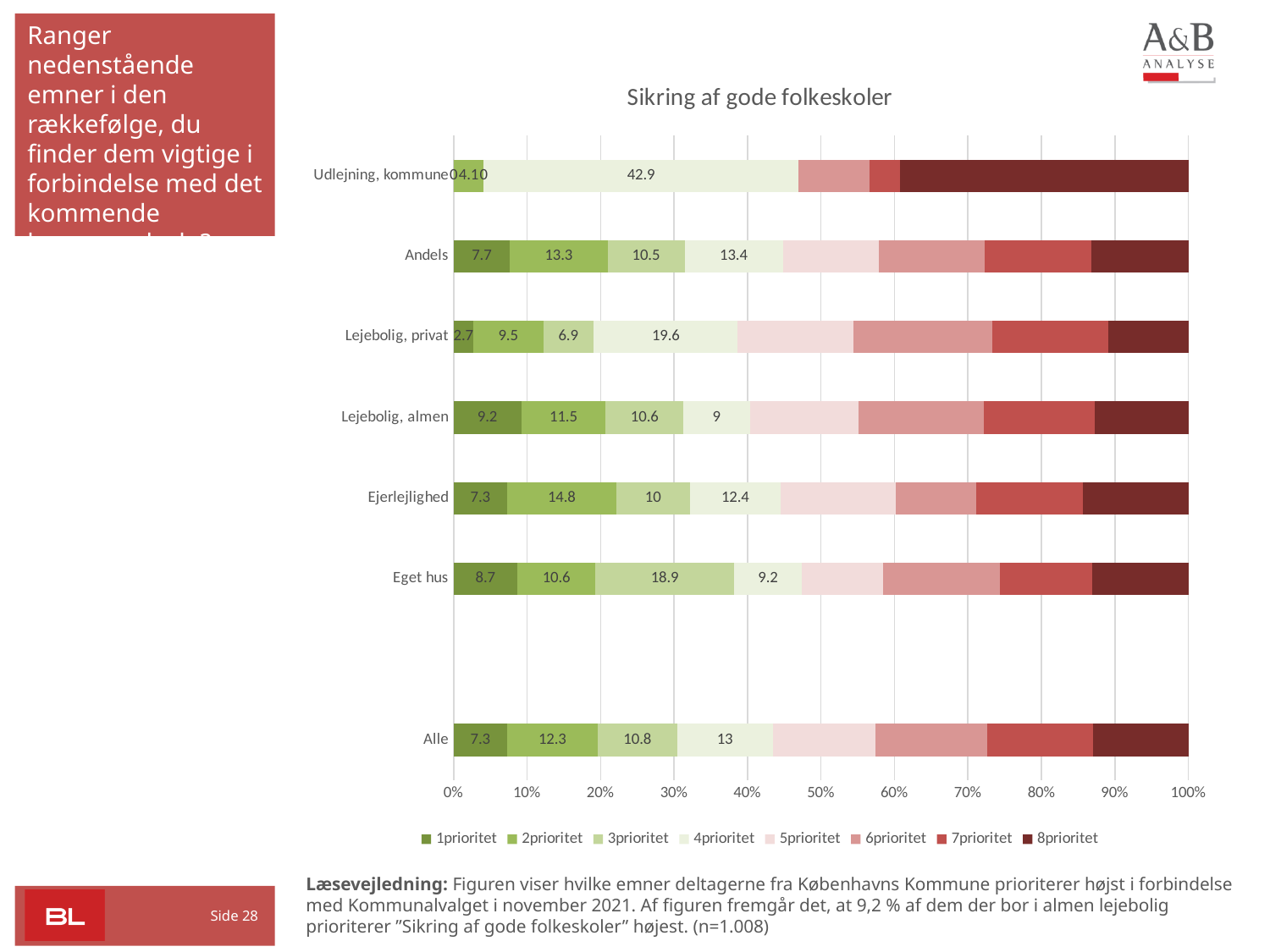
Which has the larger 3prioritet value, Eget hus or Ejerlejlighed? Eget hus How many categories are shown on the vertical axis of the chart? 7 What is the title of the chart? Sikring af gode folkeskoler How many series does the legend list? 8 What is the difference between the 2prioritet and 3prioritet values for Andels? 2.8 What is the 4prioritet value for Udlejning, kommune? 42.9 Which category has the highest 4prioritet value? Udlejning, kommune What is the 1prioritet value for Lejebolig, almen? 9.2 What is the 3prioritet value for Eget hus? 18.9 Which category has the highest 2prioritet value? Ejerlejlighed What is the 2prioritet value for Alle? 12.3 What type of chart is shown on the slide? Stacked bar chart